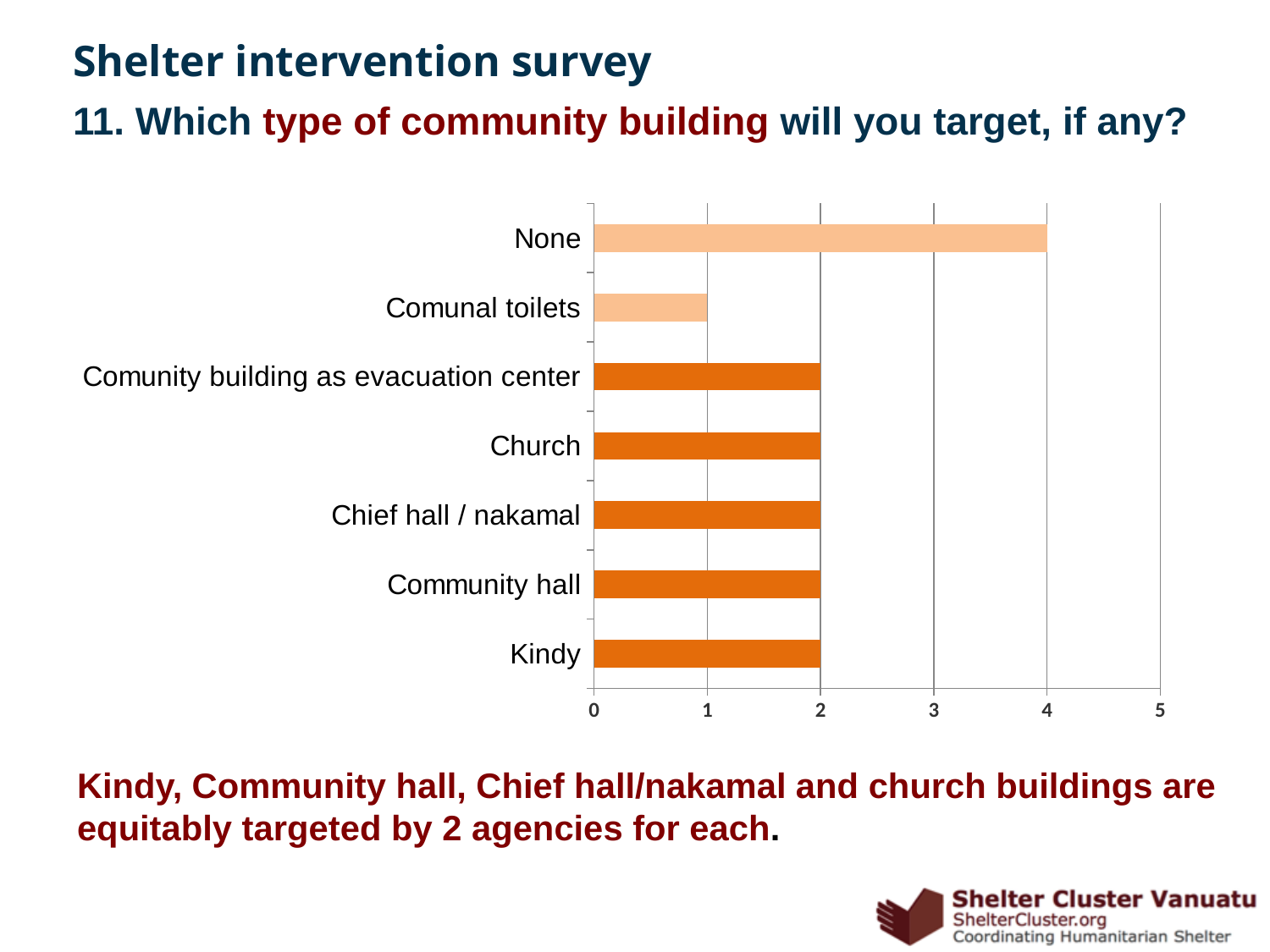
What is the value for Church? 2 What is the highest value shown on the x axis? 5 Which is larger, the value for None or the value for Community hall? None What is the value for Comunal toilets? 1 Is the value for None greater or less than 3? greater Which category has the highest value? None What kind of chart is shown on the slide? bar chart Which category has the lowest value? Comunal toilets What is the difference between the values for None and Comunal toilets? 3 What is the value for None? 4 How many categories are plotted in the chart? 7 What is the value for Kindy? 2